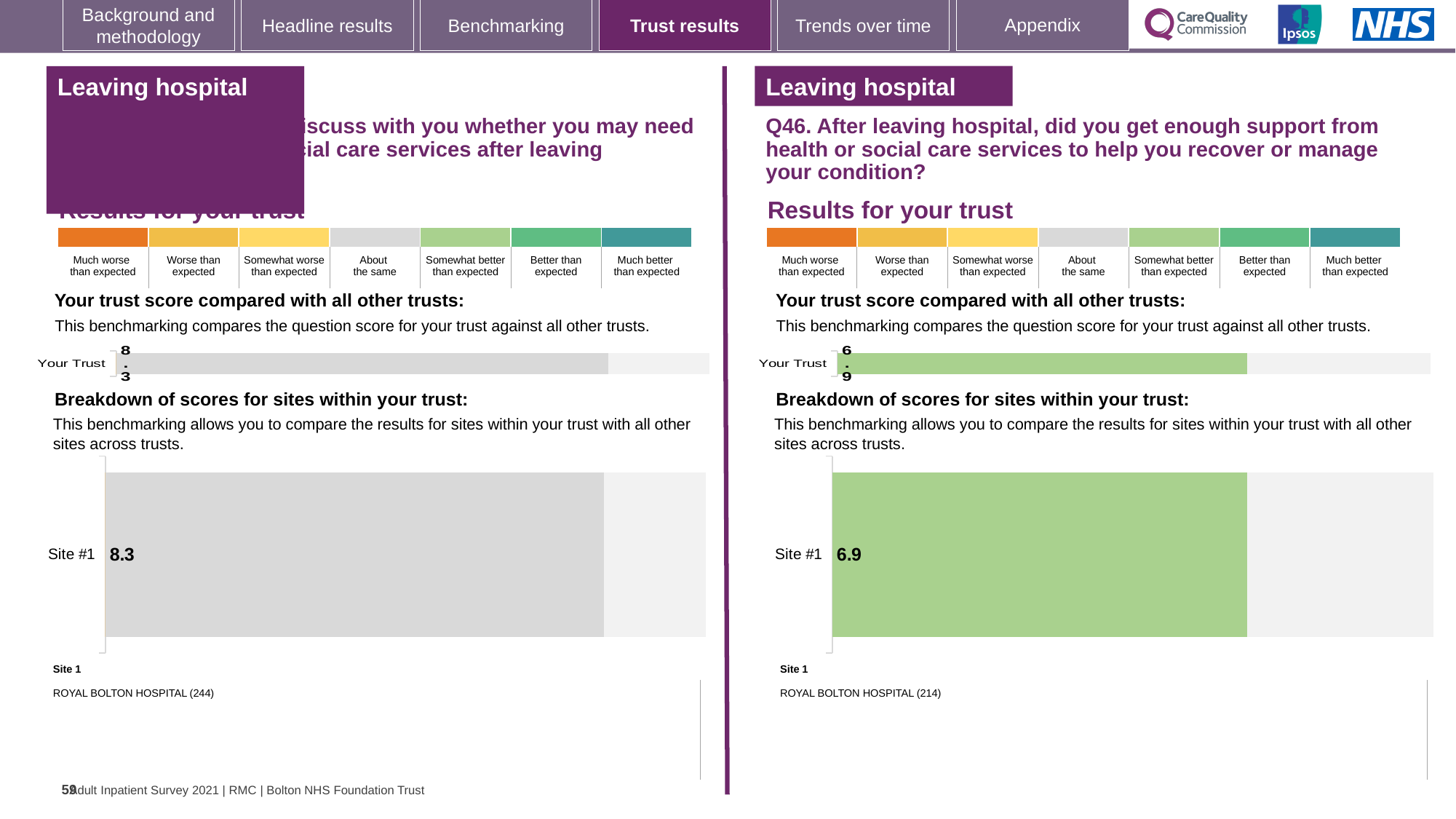
How many sites are shown in the left-hand site breakdown chart? 1 On the left-hand 'Your Trust' chart, what score is shown for Your Trust? 8.3 What colour is the Site #1 bar in the right-hand site breakdown chart for Q46? Green What is the difference between the Site #1 score on the left-hand site breakdown chart (8.3) and the Site #1 score on the right-hand Q46 site breakdown chart (6.9)? 1.4 What colour is the Site #1 bar in the left-hand site breakdown chart? Grey On the right-hand site breakdown chart for Q46, what is the score for Site #1? 6.9 Which site name is listed under the right-hand site breakdown chart for Q46? ROYAL BOLTON HOSPITAL (214) On the left-hand site breakdown chart, what is the score for Site #1? 8.3 On the right-hand chart for Q46, what is the score shown for Your Trust? 6.9 How many sites are shown in the right-hand site breakdown chart for Q46? 1 What type of chart is used to show the Site #1 score on the right-hand side for Q46? Bar chart Which is larger: the Site #1 score on the left-hand site breakdown chart or the Site #1 score on the right-hand site breakdown chart for Q46? Left-hand chart (8.3)